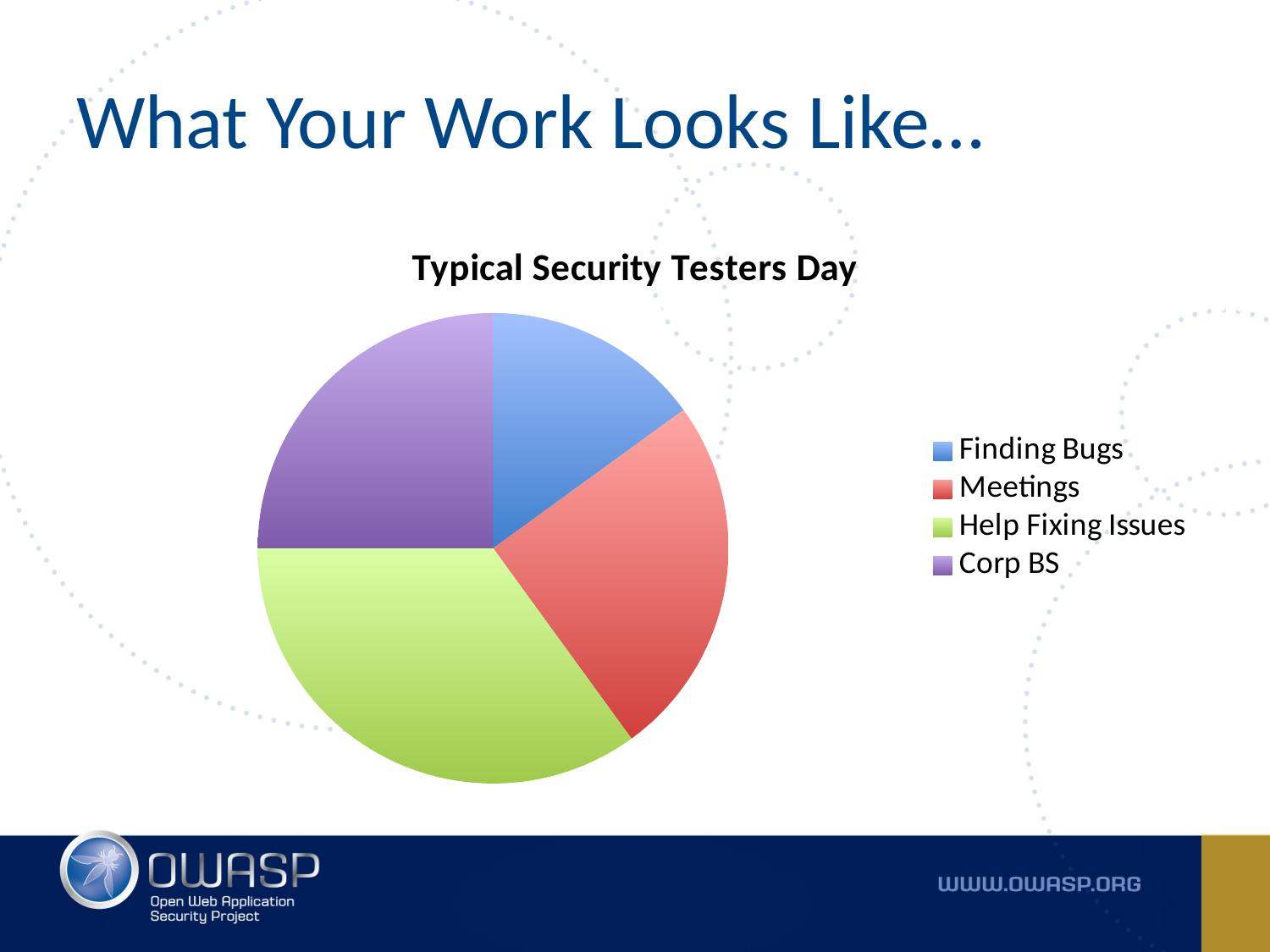
Which category takes up the largest share of the pie? Help Fixing Issues What colour is the Corp BS slice? purple How many slices does the pie chart have? 4 Which slice is larger, Help Fixing Issues or Meetings? Help Fixing Issues What is the title of the chart? Typical Security Testers Day What kind of chart is shown on the slide? pie chart How many entries does the legend list? 4 Which slice is larger, Help Fixing Issues or Finding Bugs? Help Fixing Issues Which category takes up the smallest share of the pie? Finding Bugs Which slice is larger, Corp BS or Finding Bugs? Corp BS